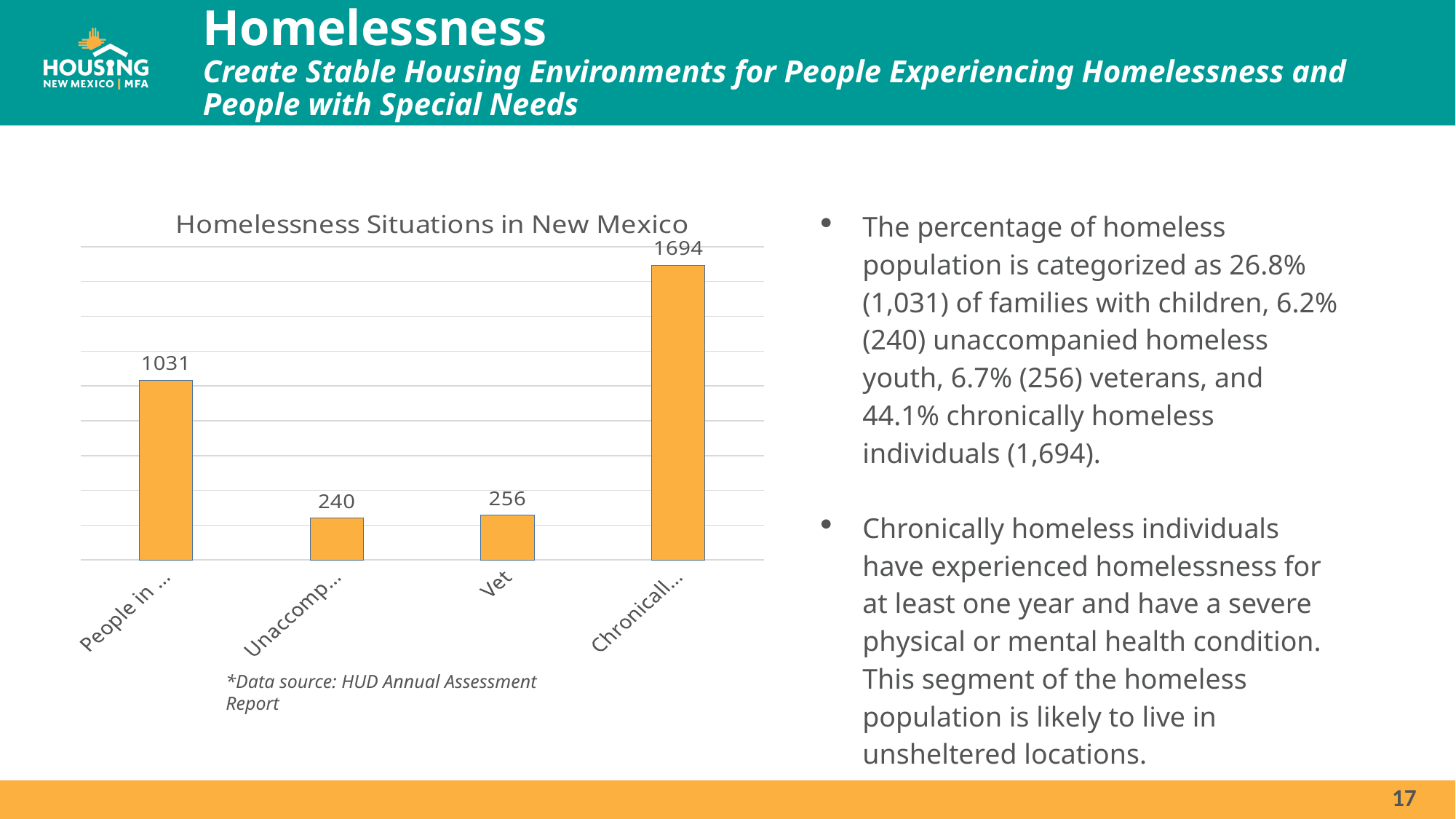
What is the value of the last bar, labelled "Chronicall..."? 1694 What is the value of the bar labelled "Unaccomp..."? 240 Which bar has the highest value? Chronicall... Which bar has the lowest value? Unaccomp... What is the difference between the "Chronicall..." bar and the "People in ..." bar? 663 What colour are the bars in the chart? Orange How many bars are plotted in the chart? 4 What is the title of the chart on the slide? Homelessness Situations in New Mexico Which is larger, the "Vet" bar or the "Unaccomp..." bar? Vet What kind of chart is shown on the slide? Bar chart What is the value of the first bar, labelled "People in ..."? 1031 What is the value of the bar labelled "Vet"? 256